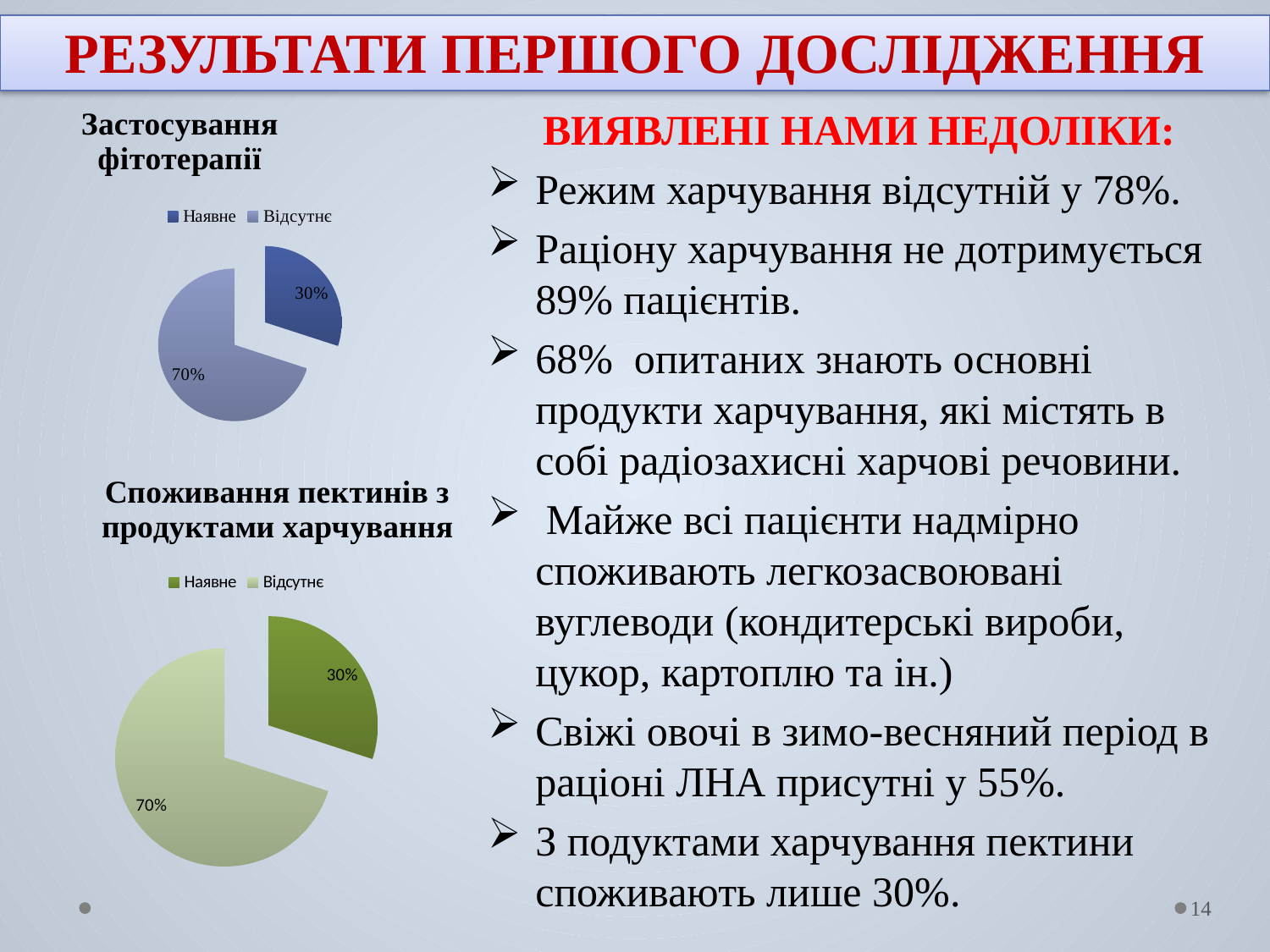
In the bottom chart 'Споживання пектинів з продуктами харчування', which is larger, 'Наявне' or 'Відсутнє'? Відсутнє In the bottom chart 'Споживання пектинів з продуктами харчування', what share of the pie is 'Наявне'? 30% How many entries does the legend of the top chart 'Застосування фітотерапії' list? 2 In the top chart 'Застосування фітотерапії', what share of the pie is 'Відсутнє'? 70% In the top chart 'Застосування фітотерапії', what is the difference in percentage points between 'Відсутнє' and 'Наявне'? 40 In the top chart 'Застосування фітотерапії', what share of the pie is 'Наявне'? 30% How many slices does the bottom chart 'Споживання пектинів з продуктами харчування' have? 2 In the bottom chart 'Споживання пектинів з продуктами харчування', which category has the smallest slice? Наявне What is the title of the bottom pie chart on the slide? Споживання пектинів з продуктами харчування In the top chart 'Застосування фітотерапії', which category has the largest slice? Відсутнє What type of chart is the top chart 'Застосування фітотерапії'? Pie chart